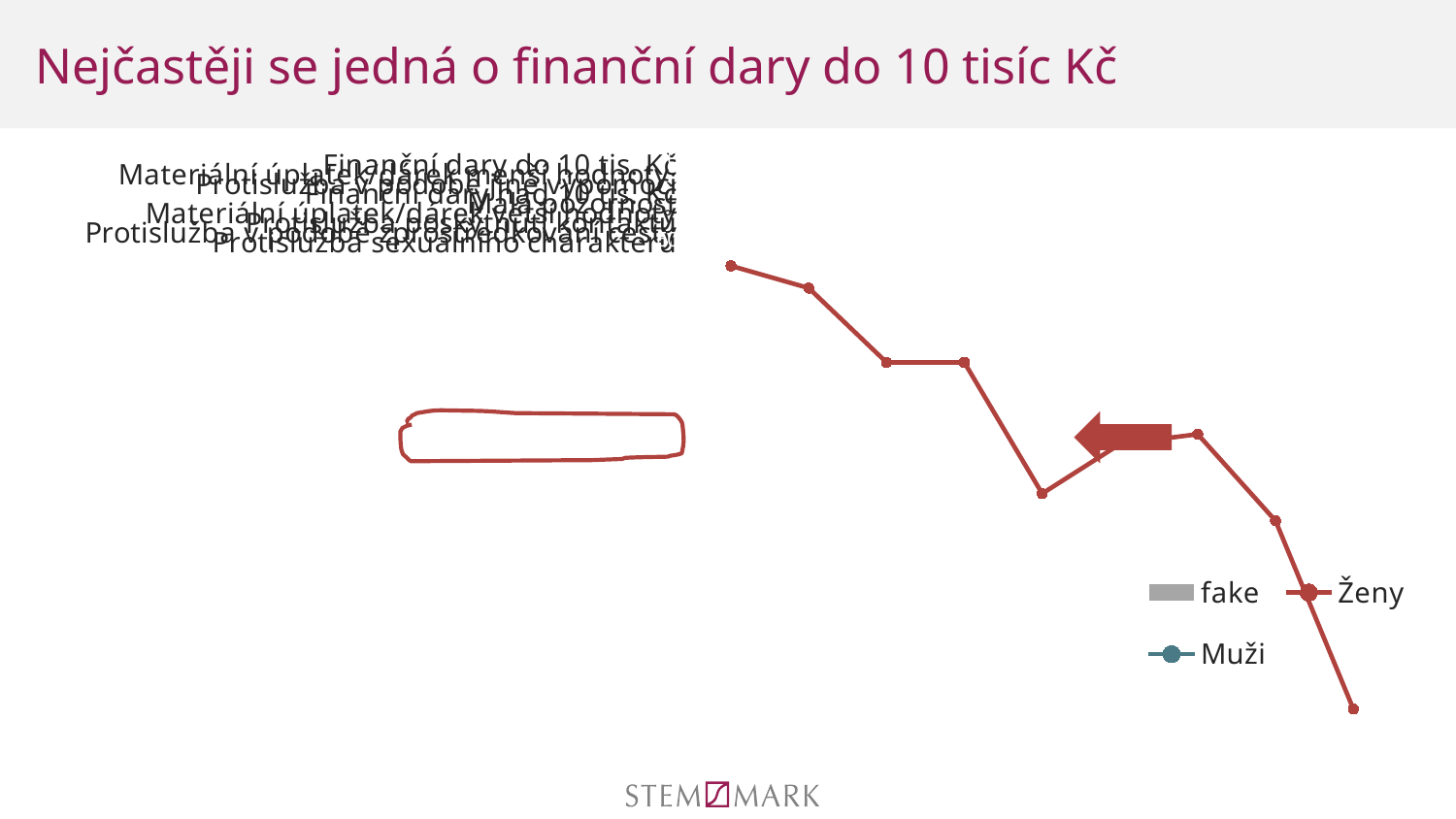
What kind of chart is shown on the slide? line chart Do the values of the red line generally rise or fall from left to right along the x axis? fall What are the entries listed in the legend? fake, Ženy, Muži Which series is plotted with the red line? Ženy How many series does the legend list? 3